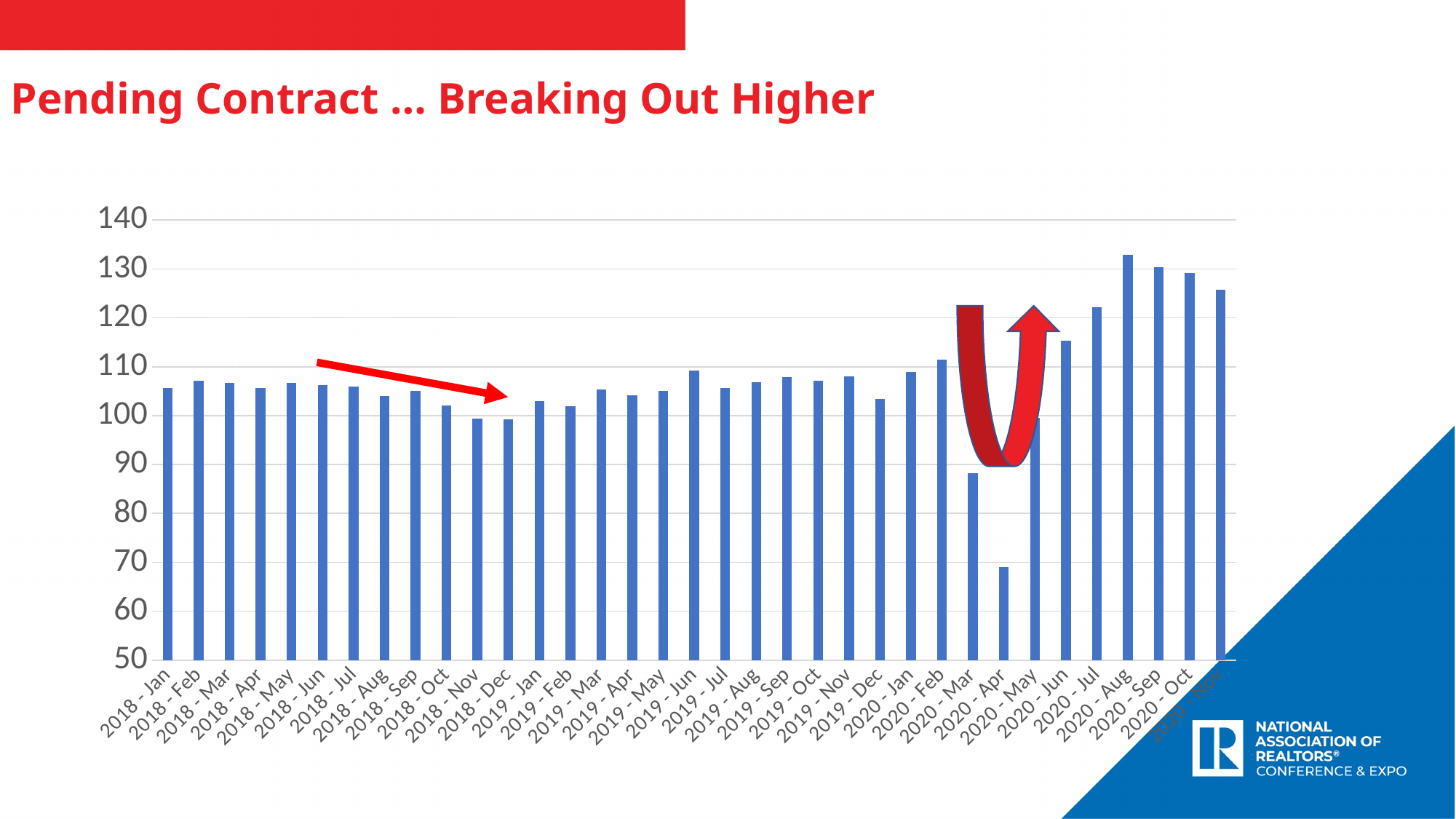
Do the values rise or fall from 2020 - Apr to 2020 - Aug? rise Is the value for 2018 - Jan greater or less than 100? greater What kind of chart is shown on the slide? bar chart Which month has the lowest bar in the chart? 2020 - Apr Which month has the highest bar in the chart? 2020 - Aug How many monthly bars are plotted in the chart? 35 Is the value for 2020 - Mar greater or less than 100? less What is the title of the slide? Pending Contract … Breaking Out Higher Which is larger, the value for 2019 - Jun or the value for 2018 - Nov? 2019 - Jun Which is larger, the value for 2020 - Sep or the value for 2020 - Nov? 2020 - Sep Is the value for 2020 - Apr greater or less than 80? less